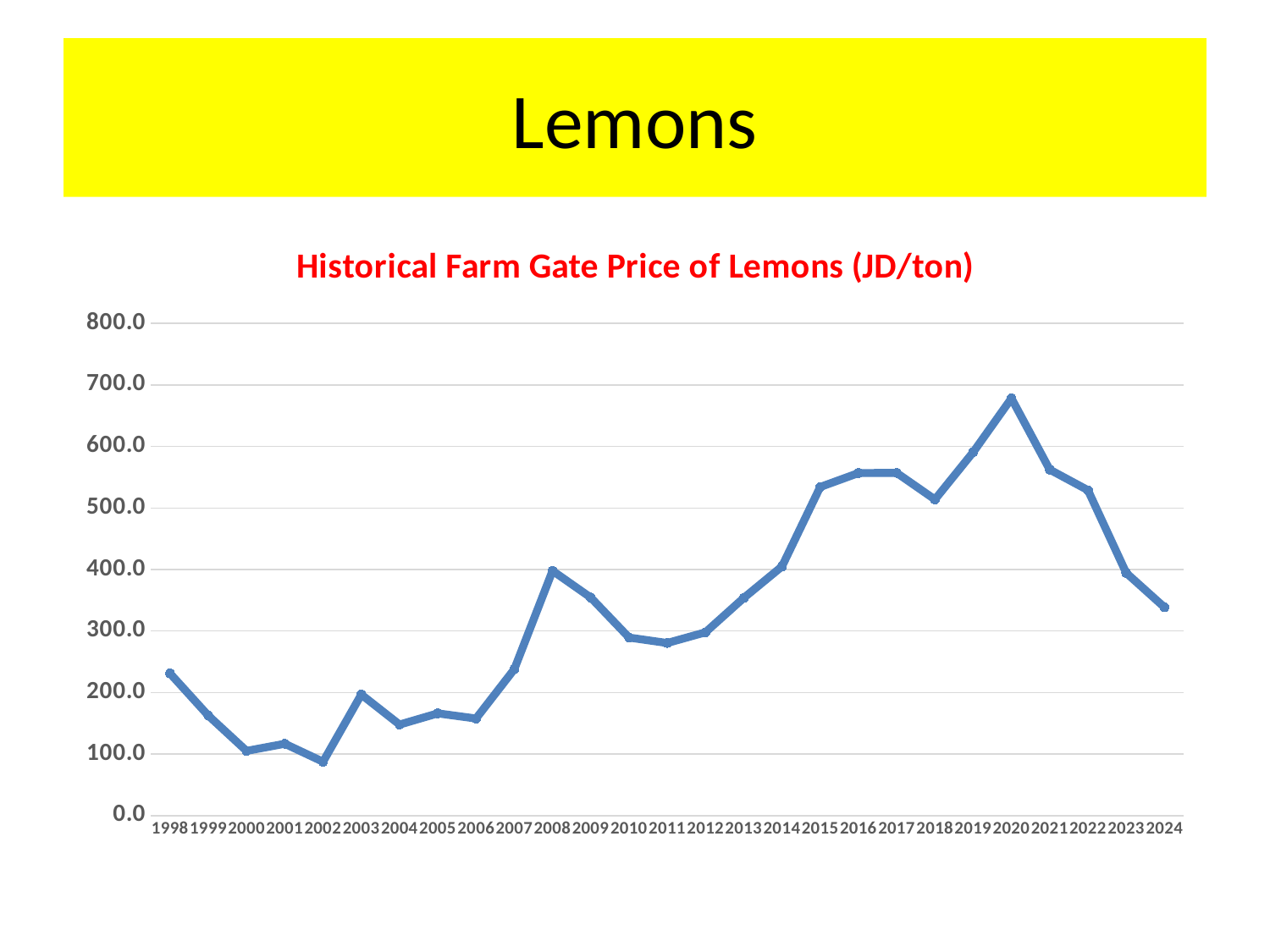
What is the title of the chart? Historical Farm Gate Price of Lemons (JD/ton) Is the value for 2016 greater or less than 500? greater Which year has a higher farm gate price, 2008 or 2016? 2016 What type of chart is shown on the slide? line chart Does the farm gate price rise or fall from 2020 to 2024? fall Is the value for 2020 greater or less than 600? greater How many years are plotted on the x axis of the chart? 27 In which year is the farm gate price of lemons lowest? 2002 In which year is the farm gate price of lemons highest? 2020 Which year has a higher farm gate price, 1998 or 2024? 2024 Is the value for 2005 greater or less than 200? less